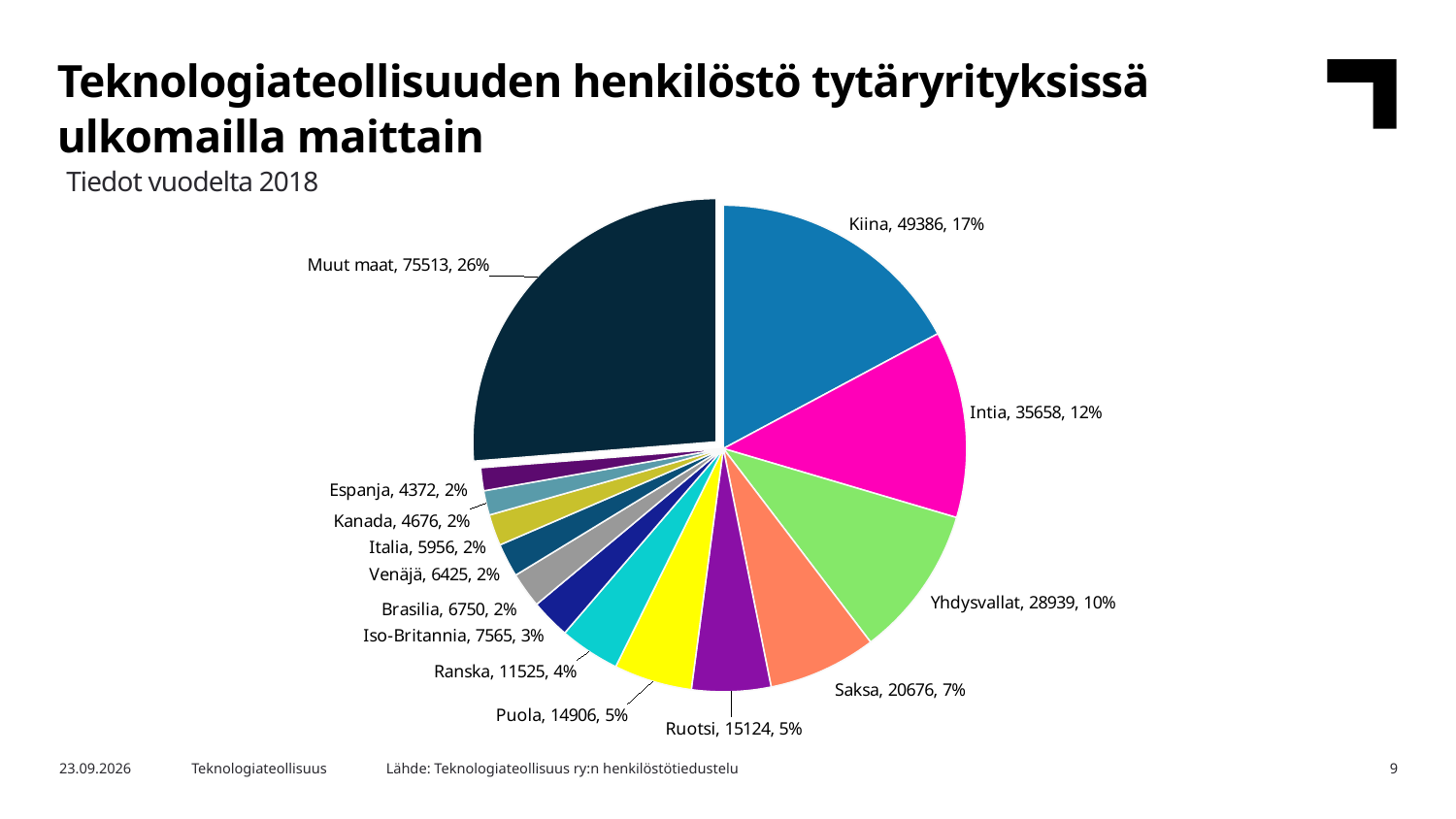
Which slice is the largest? Muut maat What is the value for Kiina? 49386 What year does the data on the slide come from? 2018 How many slices does the pie chart have? 14 What is the difference between the values for Kiina and Intia? 13728 What share of the pie does Yhdysvallat represent? 10% What share of the pie does Intia represent? 12% What is the value for Saksa? 20676 Which slice is the smallest? Espanja What is the value for Iso-Britannia? 7565 Which is larger, the value for Ruotsi or the value for Puola? Ruotsi What kind of chart is shown on the slide? Pie chart